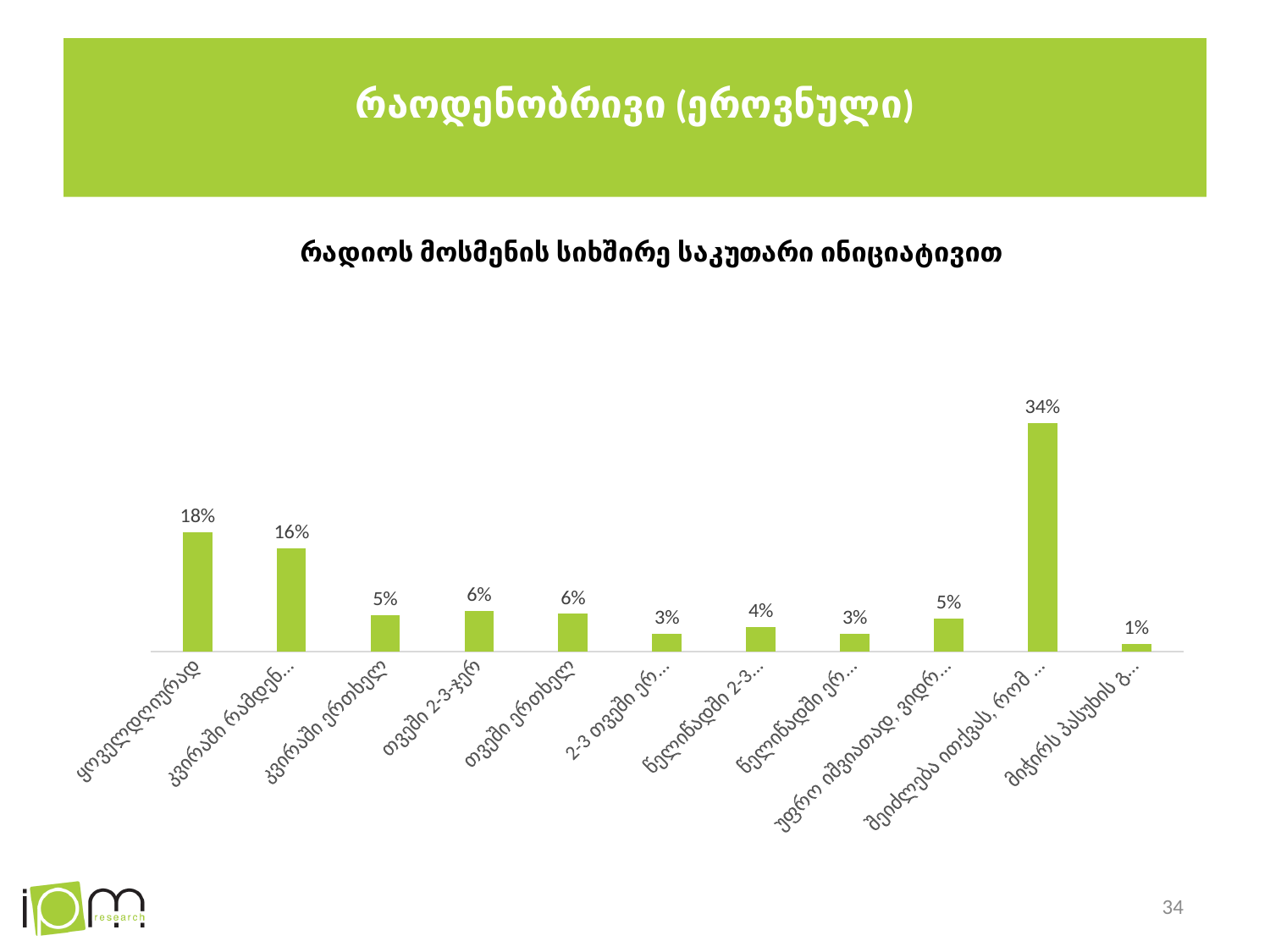
What is the difference between the value for ყოველდღიურად and the value for კვირაში ერთხელ? 13% What is the value for თვეში 2-3-ჯერ? 6% What is the value for კვირაში ერთხელ? 5% What is the value of the second bar from the left? 16% What type of chart is shown on the slide? bar chart What is the value of the shortest bar in the chart? 1% What is the title of the chart? რადიოს მოსმენის სიხშირე საკუთარი ინიციატივით What is the value for თვეში ერთხელ? 6% Which is larger, the value for ყოველდღიურად or the value for თვეში ერთხელ? ყოველდღიურად What is the value for ყოველდღიურად? 18% How many bars are plotted in the chart? 11 What is the value of the tallest bar in the chart? 34%